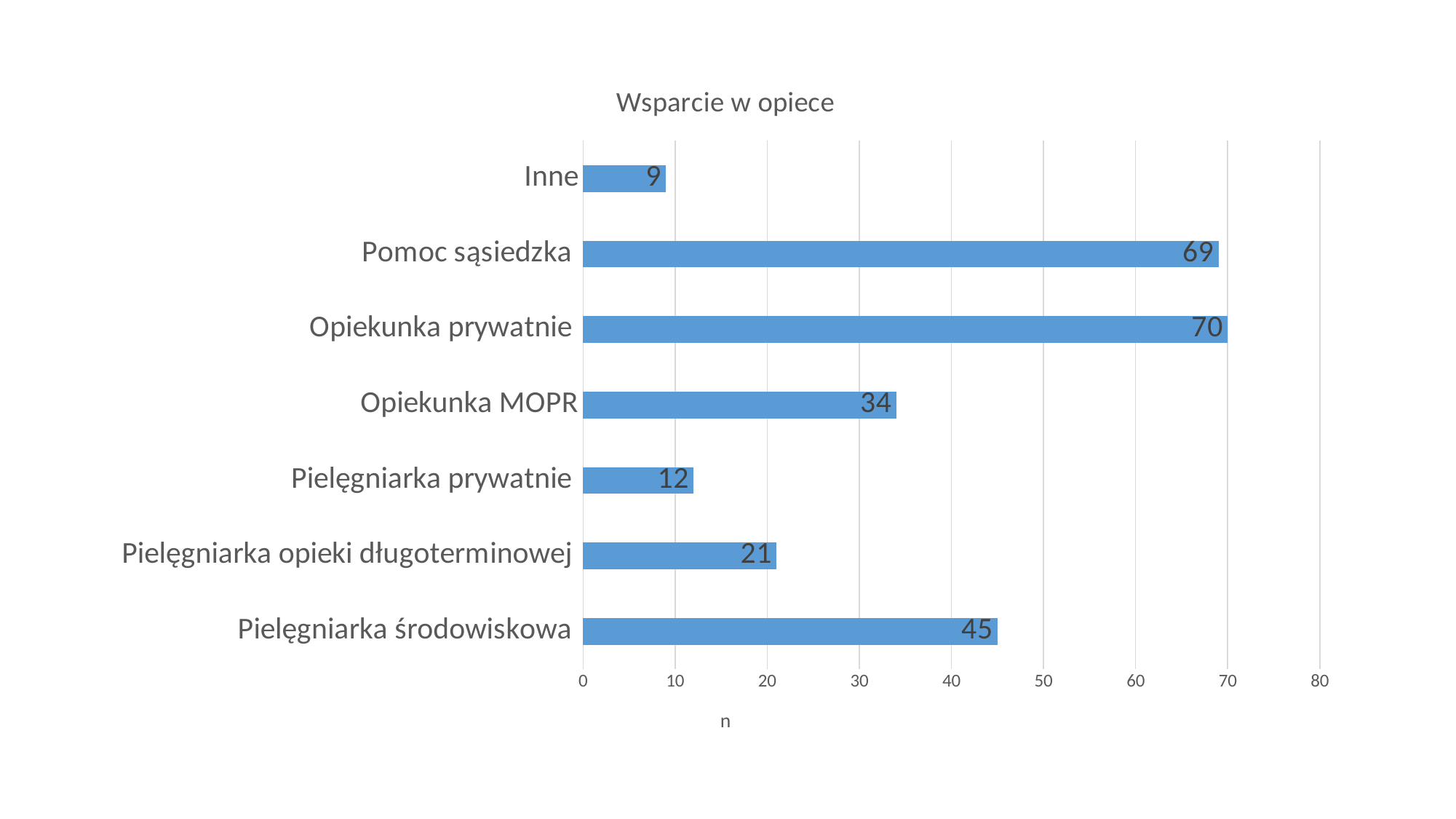
How many categories are shown in the chart? 7 What is the label of the horizontal axis? n Which category has the highest value? Opiekunka prywatnie What is the difference between Pomoc sąsiedzka and Pielęgniarka opieki długoterminowej? 48 Which is larger, Pielęgniarka prywatnie or Pielęgniarka opieki długoterminowej? Pielęgniarka opieki długoterminowej What is the title of the chart? Wsparcie w opiece What is the value for Inne? 9 Is the value for Pielęgniarka środowiskowa greater or less than 40? greater What is the value for Opiekunka MOPR? 34 What kind of chart is shown on the slide? bar chart What is the value for Pielęgniarka środowiskowa? 45 Which category has the lowest value? Inne